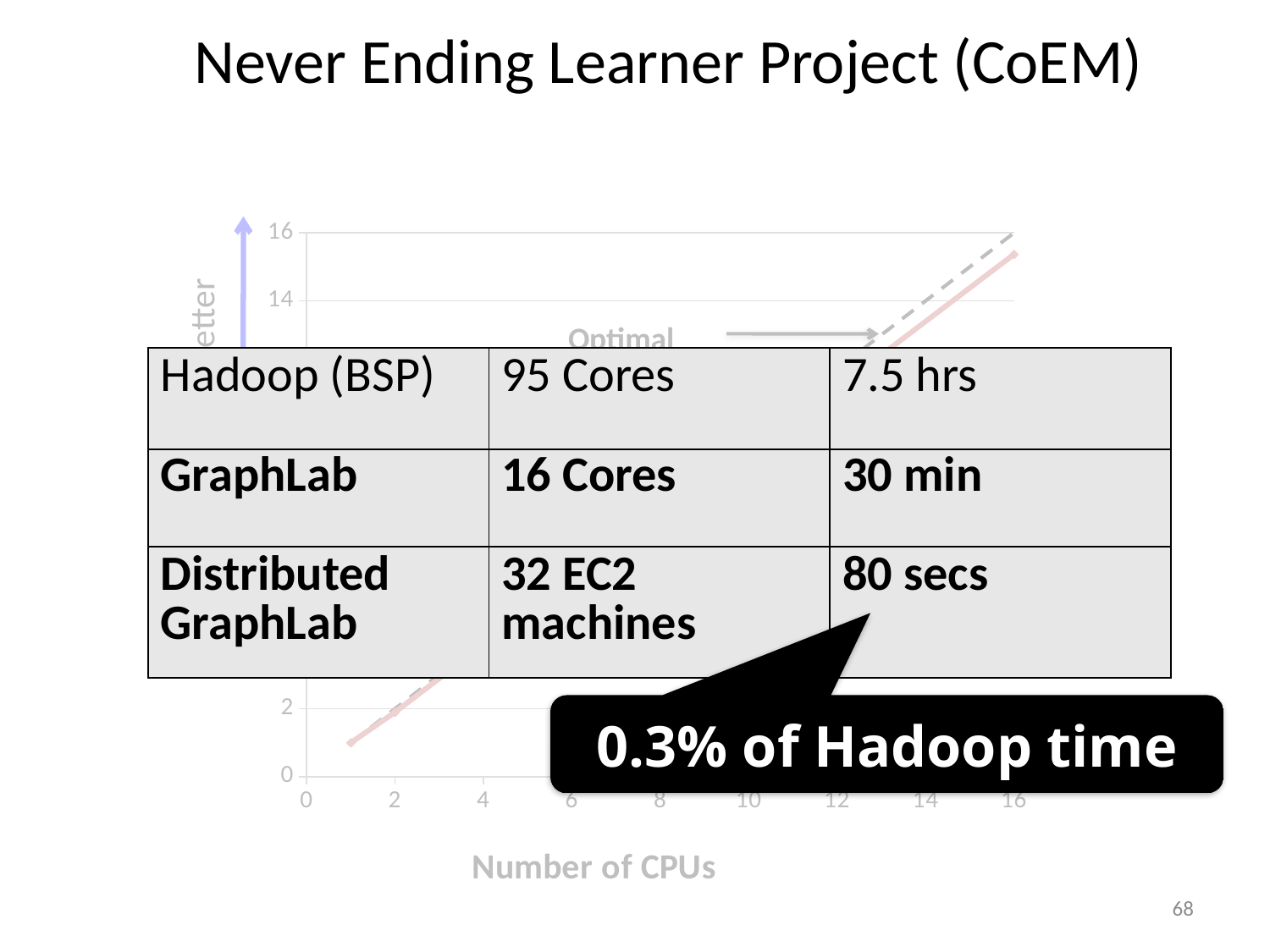
Is the value of the solid line at 16 CPUs greater or less than 14? greater Is the value of the solid line at 1 CPU greater or less than 2? less What label is given to the dashed reference line on the chart? Optimal Does the plotted line rise or fall as the number of CPUs increases? rise What is the highest tick value shown on the x axis of the chart? 16 What kind of chart is shown on the slide behind the table? line chart What is the highest tick value shown on the y axis of the chart? 16 How many tick marks are labelled on the x axis of the chart? 9 What is the title of the x axis of the chart? Number of CPUs